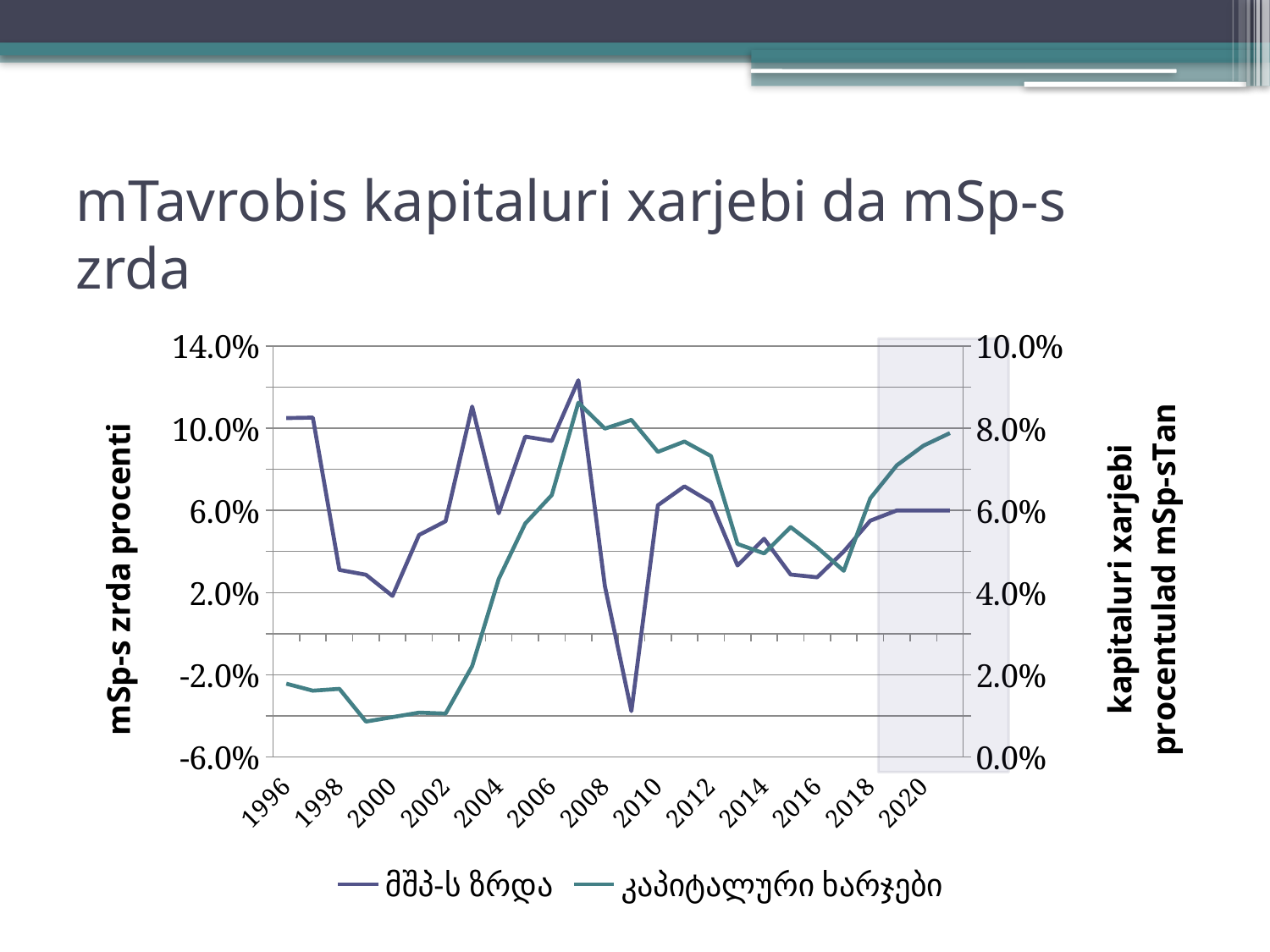
Is the value of მშპ-ს ზრდა in 2009 greater or less than 0.0%? less Is the value of კაპიტალური ხარჯები in 2000 greater or less than 2.0% on the right axis? less Which is larger, the მშპ-ს ზრდა value in 1996 or in 2000? 1996 What is the highest value shown on the right vertical axis? 10.0% In which year does the მშპ-ს ზრდა series reach its lowest value? 2009 Does the კაპიტალური ხარჯები series rise or fall between 2002 and 2007? rise What kind of chart is shown on the slide? line chart In which year does the მშპ-ს ზრდა series reach its highest value? 2007 Is the value of კაპიტალური ხარჯები in 2020 greater or less than 6.0% on the right axis? greater How many series does the legend list? 2 What is the label of the left vertical axis? mSp-s zrda procenti